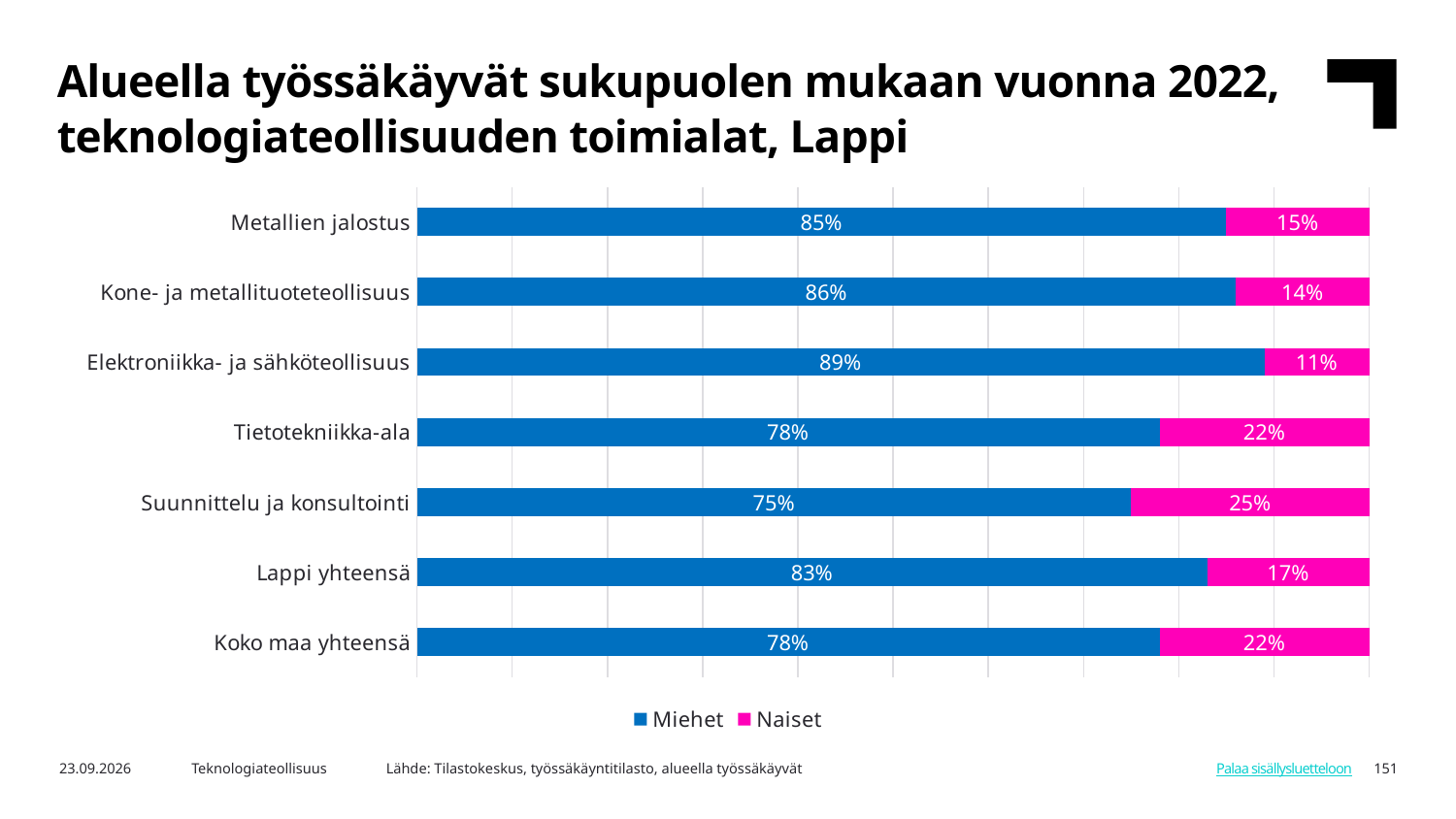
What is the Naiset share for Lappi yhteensä? 17% Which series is shown in pink? Naiset Which is larger: the Naiset share for Kone- ja metallituoteteollisuus or the Naiset share for Lappi yhteensä? Lappi yhteensä How many categories are shown on the chart? 7 What kind of chart is shown on the slide? Stacked bar chart Which category has the highest Miehet share? Elektroniikka- ja sähköteollisuus What is the difference between the Naiset share for Tietotekniikka-ala and the Naiset share for Elektroniikka- ja sähköteollisuus? 11% What is the Naiset share for Suunnittelu ja konsultointi? 25% What is the Miehet share for Metallien jalostus? 85% What is the total of the stacked bar for Koko maa yhteensä? 100% Which category has the lowest Miehet share? Suunnittelu ja konsultointi How many series does the legend list? 2